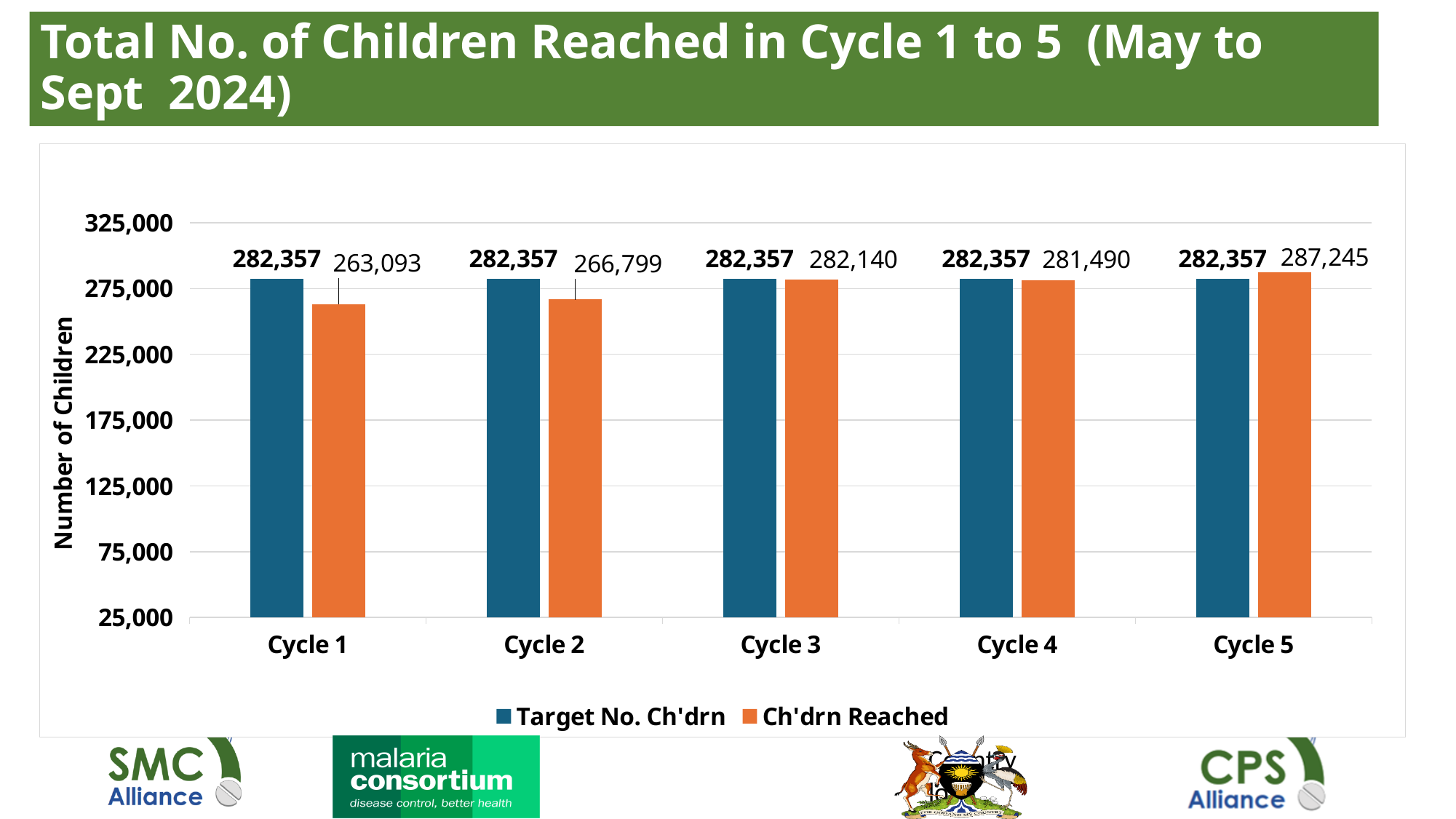
How many series does the legend list? 2 In which cycle is the Ch'drn Reached value highest? Cycle 5 What kind of chart is shown on the slide? Bar chart What is the Ch'drn Reached value for Cycle 1? 263,093 What is the Ch'drn Reached value for Cycle 5? 287,245 By how much does the Ch'drn Reached value in Cycle 5 exceed the Target No. Ch'drn? 4,888 What is the Target No. Ch'drn value for Cycle 3? 282,357 Which is larger in Cycle 2: the Target No. Ch'drn or the Ch'drn Reached? Target No. Ch'drn How many cycles are shown on the x axis? 5 In which cycle is the Ch'drn Reached value lowest? Cycle 1 Is the Ch'drn Reached value for Cycle 1 greater or less than 275,000? less What is the difference between the Target No. Ch'drn and the Ch'drn Reached in Cycle 1? 19,264